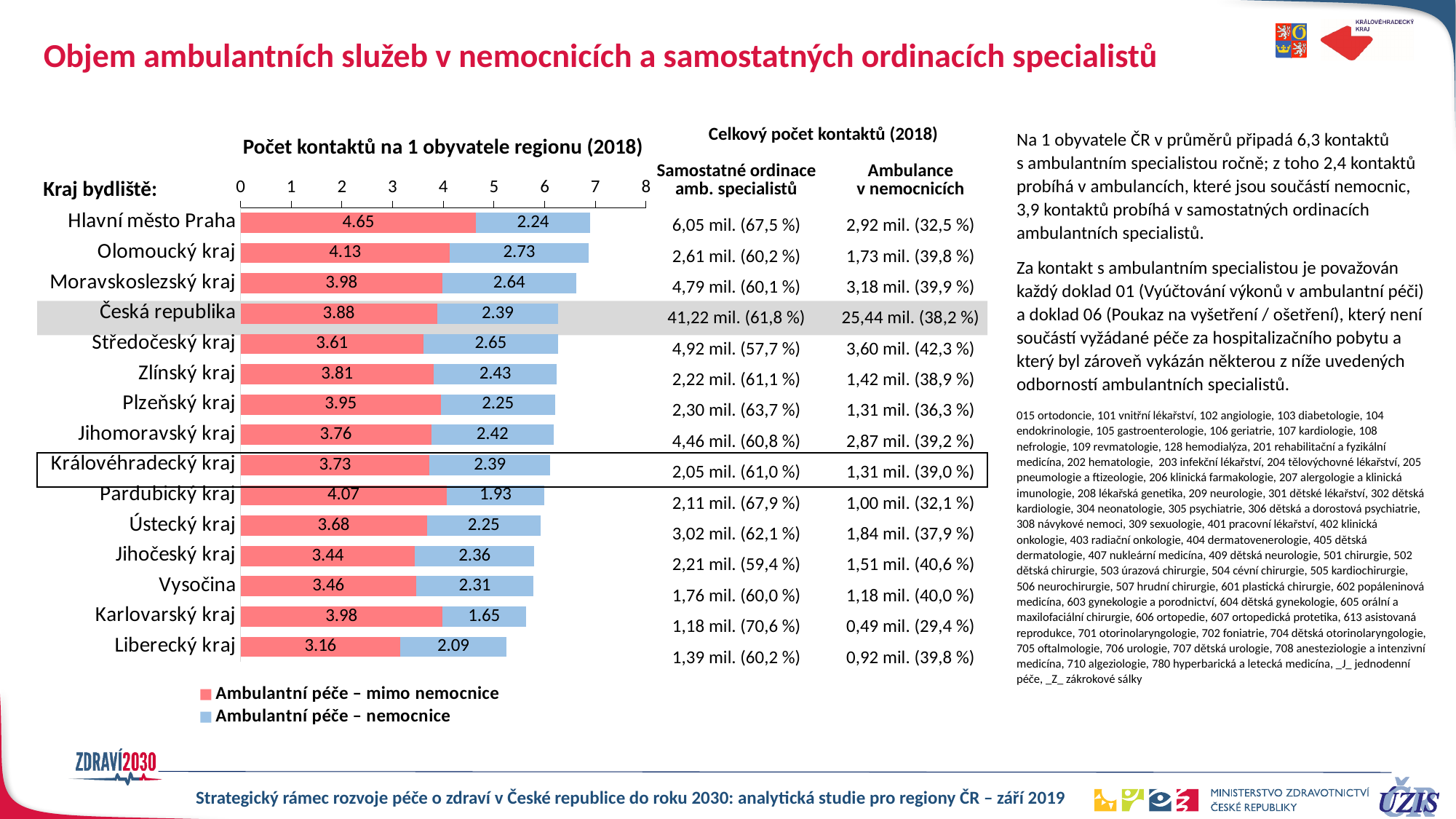
Which region has the lowest value for 'Ambulantní péče – nemocnice'? Karlovarský kraj What is the total number of contacts per inhabitant for Královéhradecký kraj (sum of both segments)? 6.12 How many regions (categories) are plotted in the chart? 15 Which region has the highest value for 'Ambulantní péče – mimo nemocnice'? Hlavní město Praha What is the value of 'Ambulantní péče – mimo nemocnice' for Hlavní město Praha? 4.65 What is the difference between the 'Ambulantní péče – mimo nemocnice' values for Hlavní město Praha and Liberecký kraj? 1.49 What is the value of 'Ambulantní péče – nemocnice' for Olomoucký kraj? 2.73 What is the value of 'Ambulantní péče – nemocnice' for Královéhradecký kraj? 2.39 Which is larger: the 'Ambulantní péče – nemocnice' value for Pardubický kraj or for Jihočeský kraj? Jihočeský kraj How many series does the chart legend list? 2 What type of chart is shown on the slide? Stacked bar chart Which region has the lowest value for 'Ambulantní péče – mimo nemocnice'? Liberecký kraj